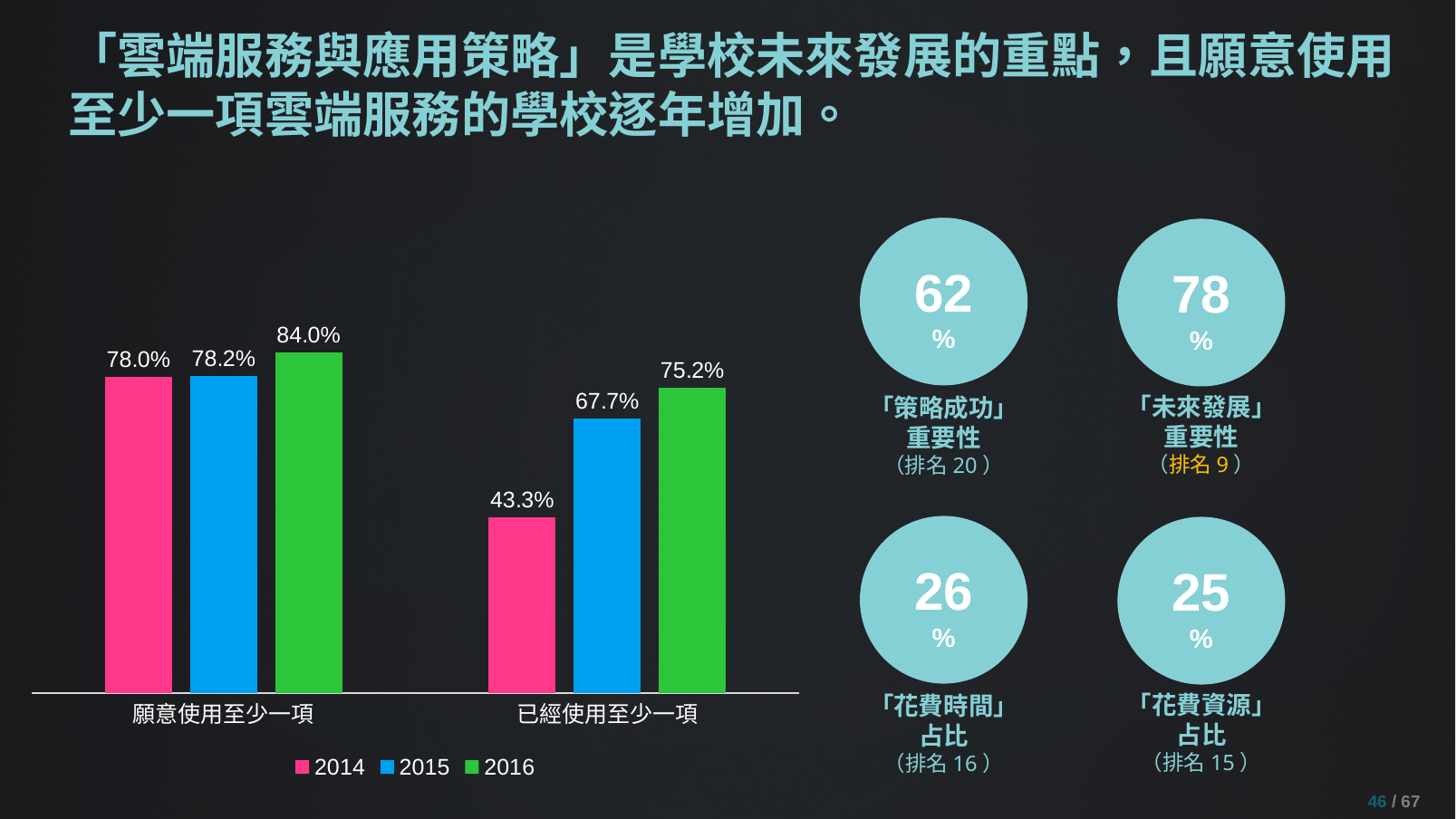
What is the value for 2016 in the 願意使用至少一項 category? 84.0% What kind of chart is shown on the left of the slide? Bar chart What is the difference between the 2016 and 2015 values in the 願意使用至少一項 category? 5.8% What is the value for 2014 in the 已經使用至少一項 category? 43.3% What is the value for 2014 in the 願意使用至少一項 category? 78.0% What is the difference between the 2016 and 2014 values in the 已經使用至少一項 category? 31.9% Which is larger: the 2016 value for 願意使用至少一項 or the 2016 value for 已經使用至少一項? 願意使用至少一項 How many series does the legend of the bar chart list? 3 What is the value for 2015 in the 已經使用至少一項 category? 67.7% Which year has the highest value in the 已經使用至少一項 category? 2016 Do the values in the 已經使用至少一項 category rise or fall from 2014 to 2016? Rise Which year has the lowest value in the 已經使用至少一項 category? 2014